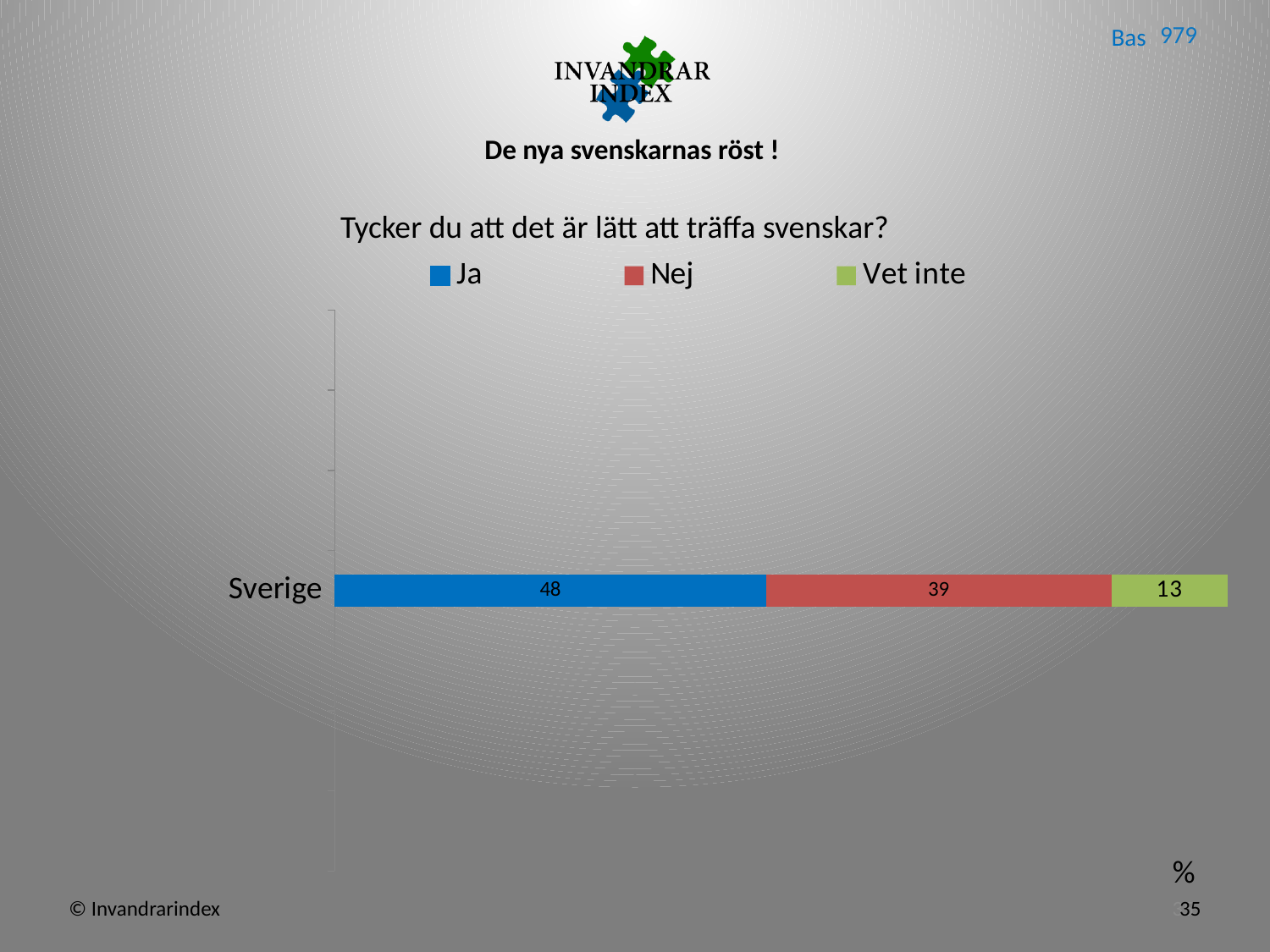
Which is larger for Sverige, "Ja" or "Nej"? Ja What is the total of the stacked bar for Sverige? 100 What kind of chart is shown on the slide? Stacked bar chart What is the difference between the "Nej" and "Vet inte" values for Sverige? 26 How many series does the legend list? 3 Which series has the highest value for Sverige? Ja What is the value for "Vet inte" for Sverige? 13 What is the difference between the "Ja" and "Nej" values for Sverige? 9 What is the title of the chart? Tycker du att det är lätt att träffa svenskar? What is the value for "Nej" for Sverige? 39 What is the value for "Ja" for Sverige? 48 Which series has the lowest value for Sverige? Vet inte